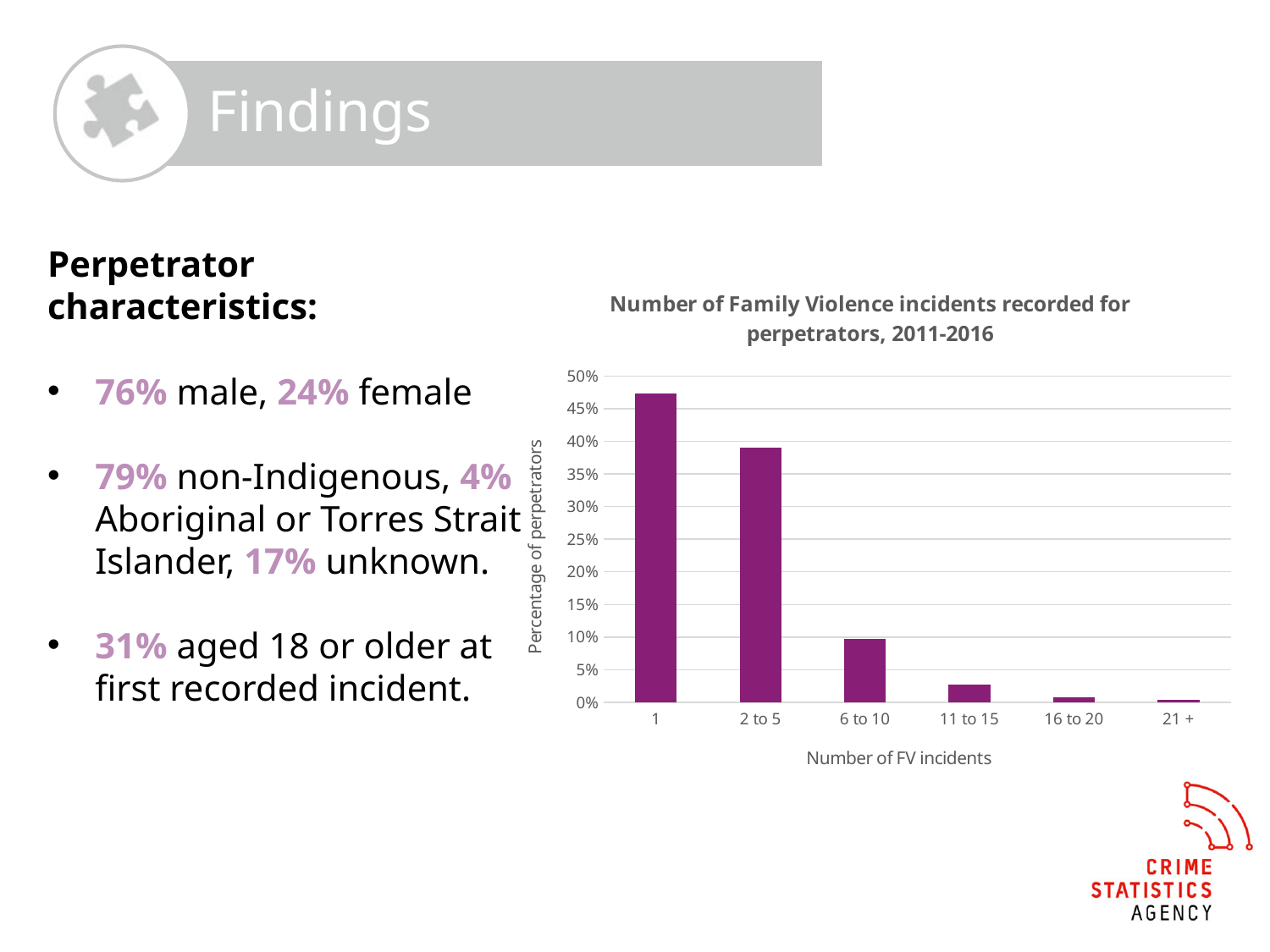
Is the value for the '6 to 10' category greater or less than 15%? less What is the label of the chart's y axis? Percentage of perpetrators What is the title of the chart? Number of Family Violence incidents recorded for perpetrators, 2011-2016 Which is larger, the value for '2 to 5' or the value for '6 to 10'? 2 to 5 Is the value for the '1' category greater or less than 45%? greater Is the value for the '16 to 20' category greater or less than 5%? less Which number of FV incidents category has the highest percentage of perpetrators? 1 What kind of chart is shown on the slide? bar chart How many categories are shown on the x axis of the chart? 6 Do the values rise or fall as the number of FV incidents increases along the x axis? fall